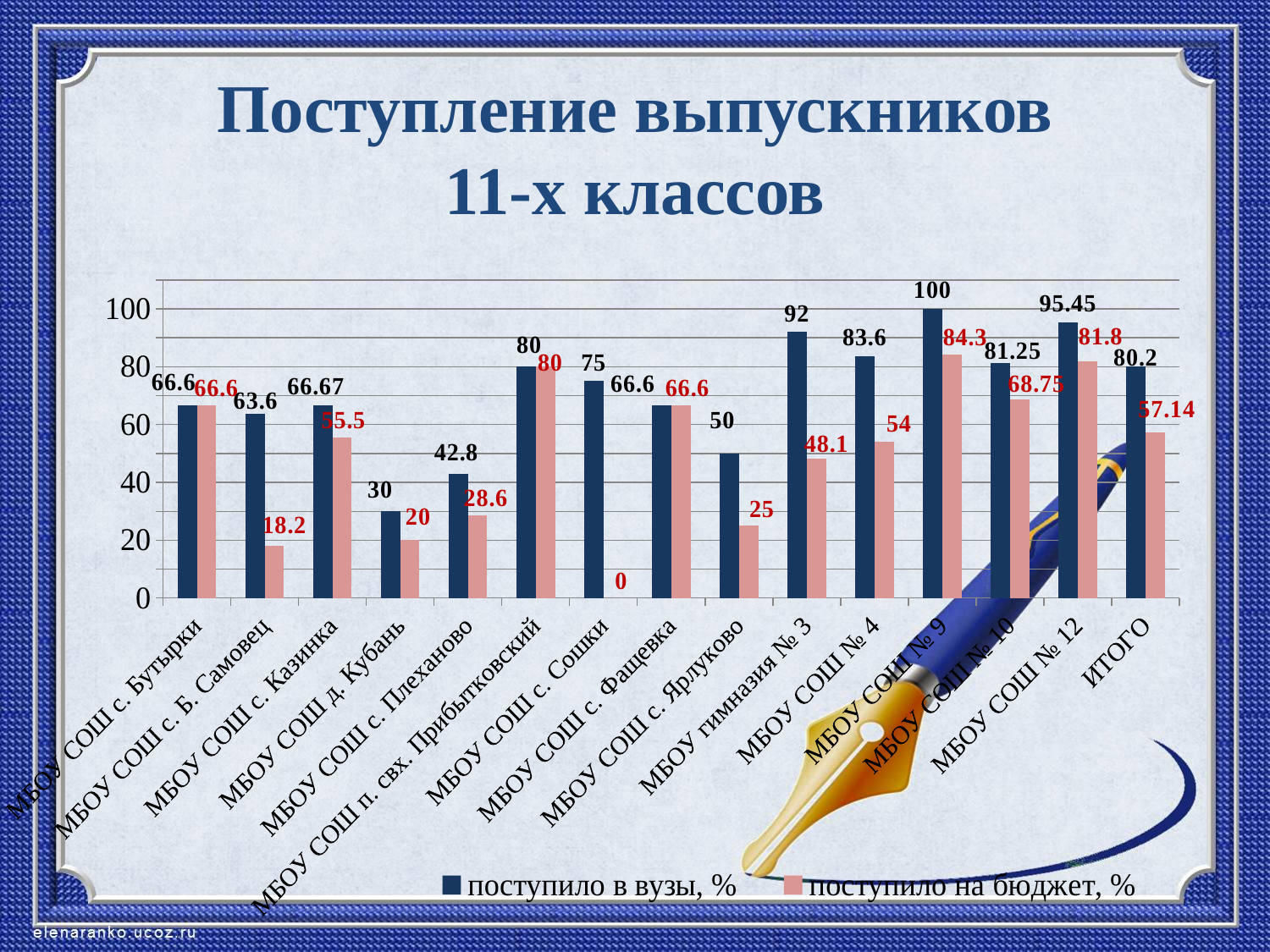
What is the value of "поступило на бюджет, %" for МБОУ СОШ № 10? 68.75 Which school has the lowest value for "поступило в вузы, %"? МБОУ СОШ д. Кубань How many categories (schools, including ИТОГО) are shown on the x axis? 15 What type of chart is shown on the slide? bar chart How many series does the legend list? 2 Which school has the lowest value for "поступило на бюджет, %"? МБОУ СОШ с. Сошки Which is larger: "поступило в вузы, %" for МБОУ СОШ № 12 or for МБОУ СОШ № 4? МБОУ СОШ № 12 What is the value of "поступило в вузы, %" for МБОУ гимназия № 3? 92 What is the value of "поступило на бюджет, %" for ИТОГО? 57.14 What is the title of the chart on the slide? Поступление выпускников 11-х классов Which school has the highest value for "поступило в вузы, %"? МБОУ СОШ № 9 What is the difference between "поступило в вузы, %" and "поступило на бюджет, %" for МБОУ СОШ с. Б. Самовец? 45.4